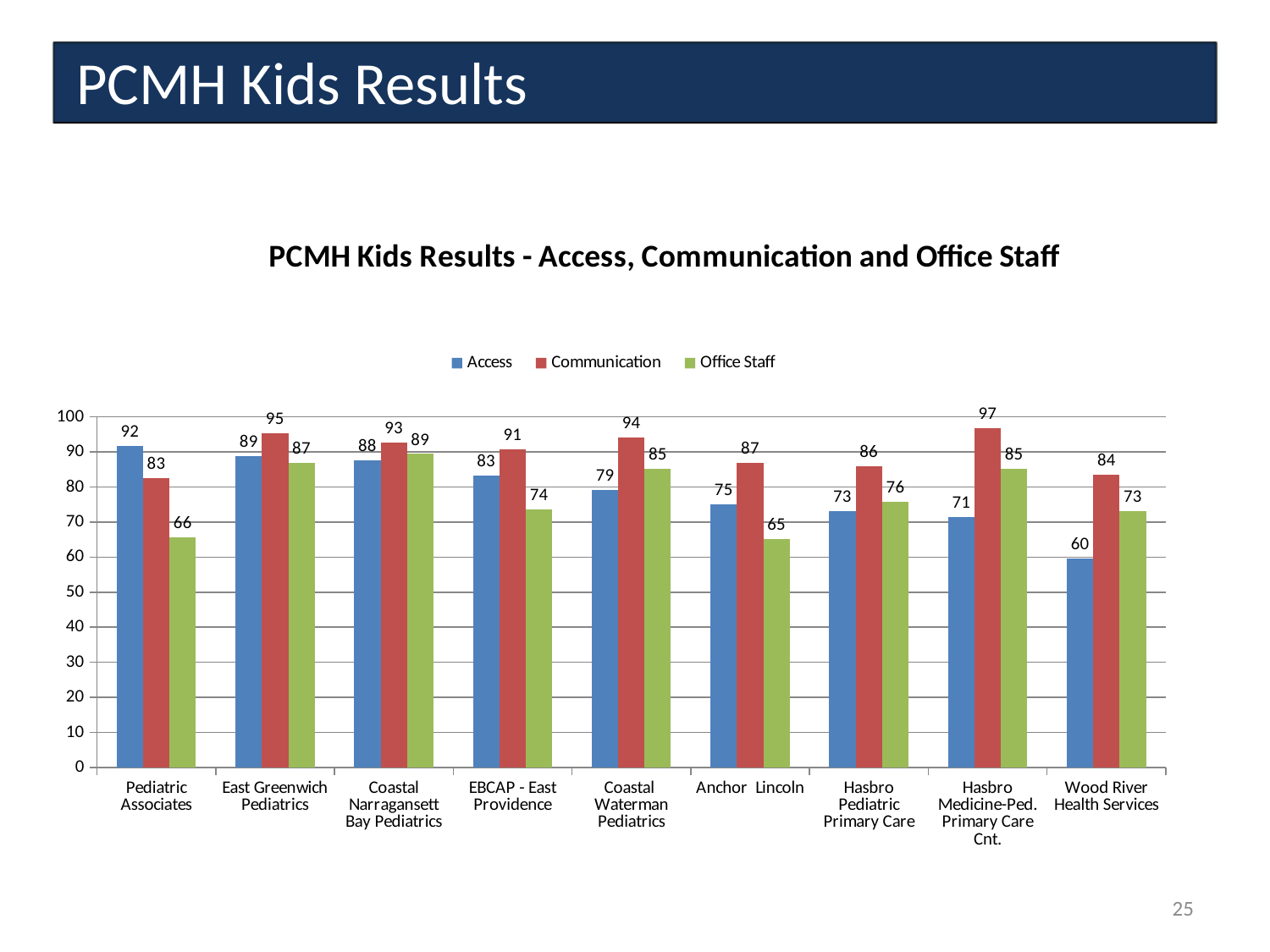
Is the Office Staff value for Pediatric Associates greater or less than 70? less Which is larger for EBCAP - East Providence, the Access value or the Office Staff value? Access Do the Access values rise or fall from left to right across the practices? Fall What is the Access value for Pediatric Associates? 92 Which practice has the lowest Access value? Wood River Health Services What is the difference between the Communication and Access values for Wood River Health Services? 24 What is the Communication value for Hasbro Medicine-Ped. Primary Care Cnt.? 97 Which practice has the highest Communication value? Hasbro Medicine-Ped. Primary Care Cnt. What kind of chart is shown on the slide? Bar chart How many practices are shown on the x axis? 9 How many series does the legend list? 3 What is the Office Staff value for Anchor Lincoln? 65